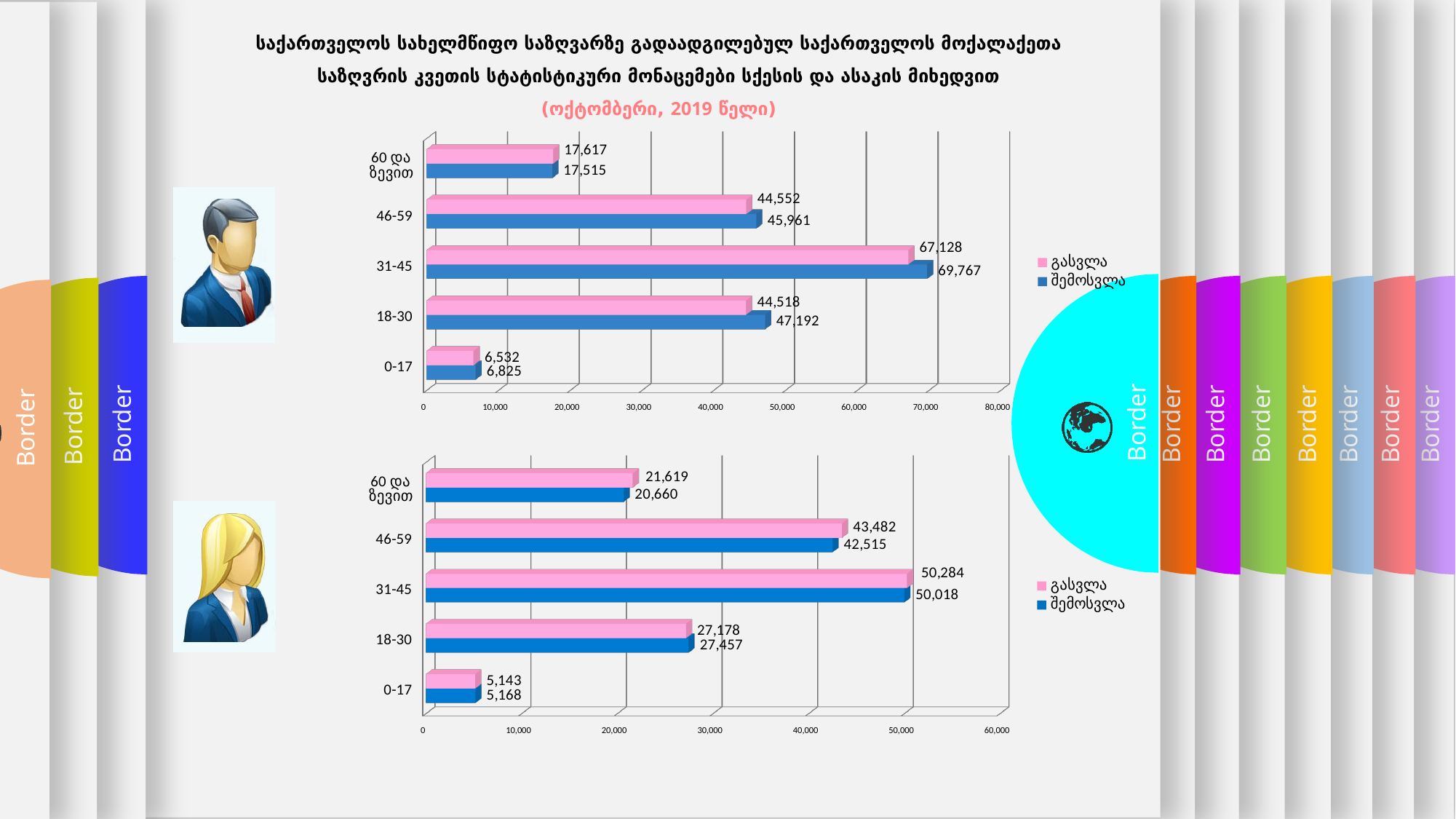
What type of chart is the bottom chart? Bar chart In the top chart, which is larger for the 46-59 age group: გასვლა or შემოსვლა? შემოსვლა In the top chart, what is the გასვლა value for the 31-45 age group? 67,128 In the top chart, which age group has the highest შემოსვლა value? 31-45 In the top chart, what is the difference between the შემოსვლა and გასვლა values for the 31-45 age group? 2,639 In the bottom chart, what is the გასვლა value for the 60 და ზევით age group? 21,619 How many age groups are shown in the bottom chart? 5 In the top chart, what is the შემოსვლა value for the 18-30 age group? 47,192 In the bottom chart, what is the შემოსვლა value for the 0-17 age group? 5,168 In the bottom chart, what is the difference between the გასვლა and შემოსვლა values for the 46-59 age group? 967 How many series does the legend of the top chart list? 2 In the bottom chart, which age group has the lowest გასვლა value? 0-17